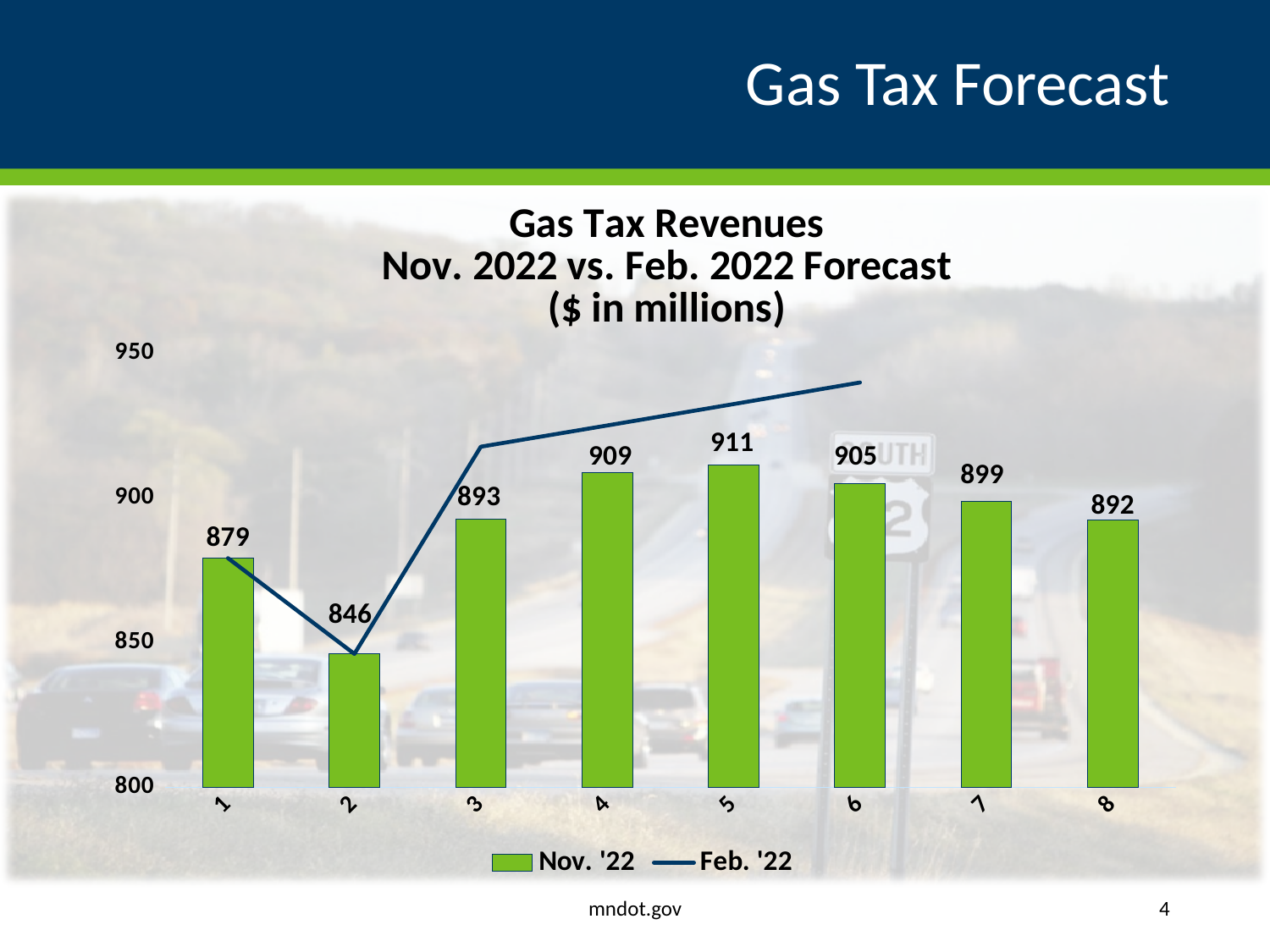
How many categories are shown on the x axis? 8 Which is larger, the Nov. '22 value for category 1 or for category 7? Category 7 Is the Feb. '22 value for category 3 greater or less than 900? greater What is the Nov. '22 value for category 2? 846 Do the Nov. '22 values rise or fall from category 2 to category 5? rise What is the difference between the Nov. '22 values for category 5 and category 2? 65 What unit does the chart title say the values are in? $ in millions How many series does the legend list? 2 Which category has the lowest Nov. '22 value? 2 What is the Nov. '22 value for category 8? 892 Which category has the highest Nov. '22 value? 5 What is the Nov. '22 value for category 4? 909